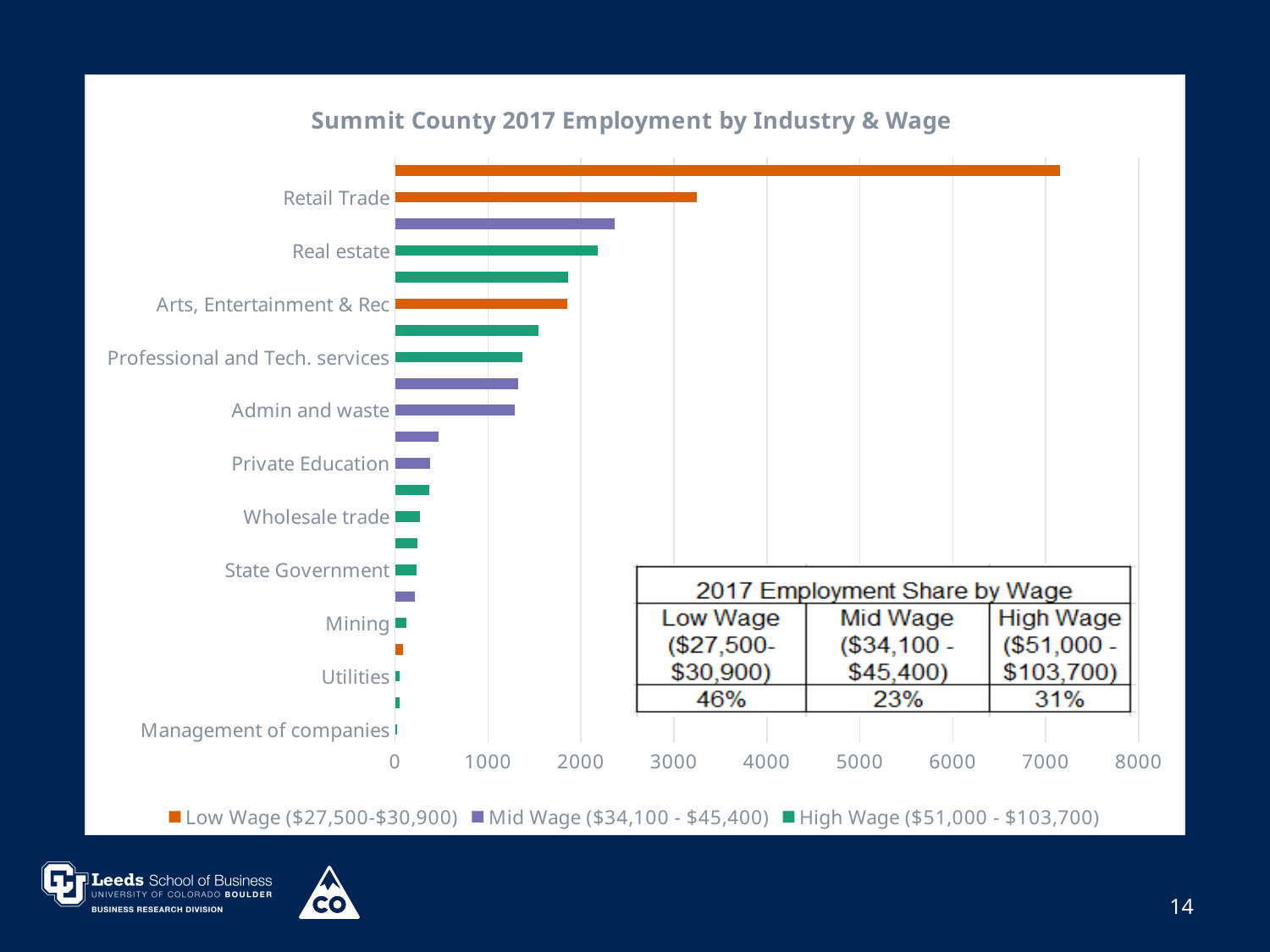
According to the 2017 Employment Share by Wage table, what share of employment is Low Wage? 46% What is the title of the chart? Summit County 2017 Employment by Industry & Wage Is the value for Admin and waste greater or less than 1000? greater How many series does the chart legend list? 3 Is the value for Private Education greater or less than 1000? less What kind of chart is shown on the slide? bar chart Is the value for Mining greater or less than 1000? less Which wage series does the Retail Trade bar belong to? Low Wage ($27,500-$30,900) Which is larger, the value for Retail Trade or the value for Real estate? Retail Trade